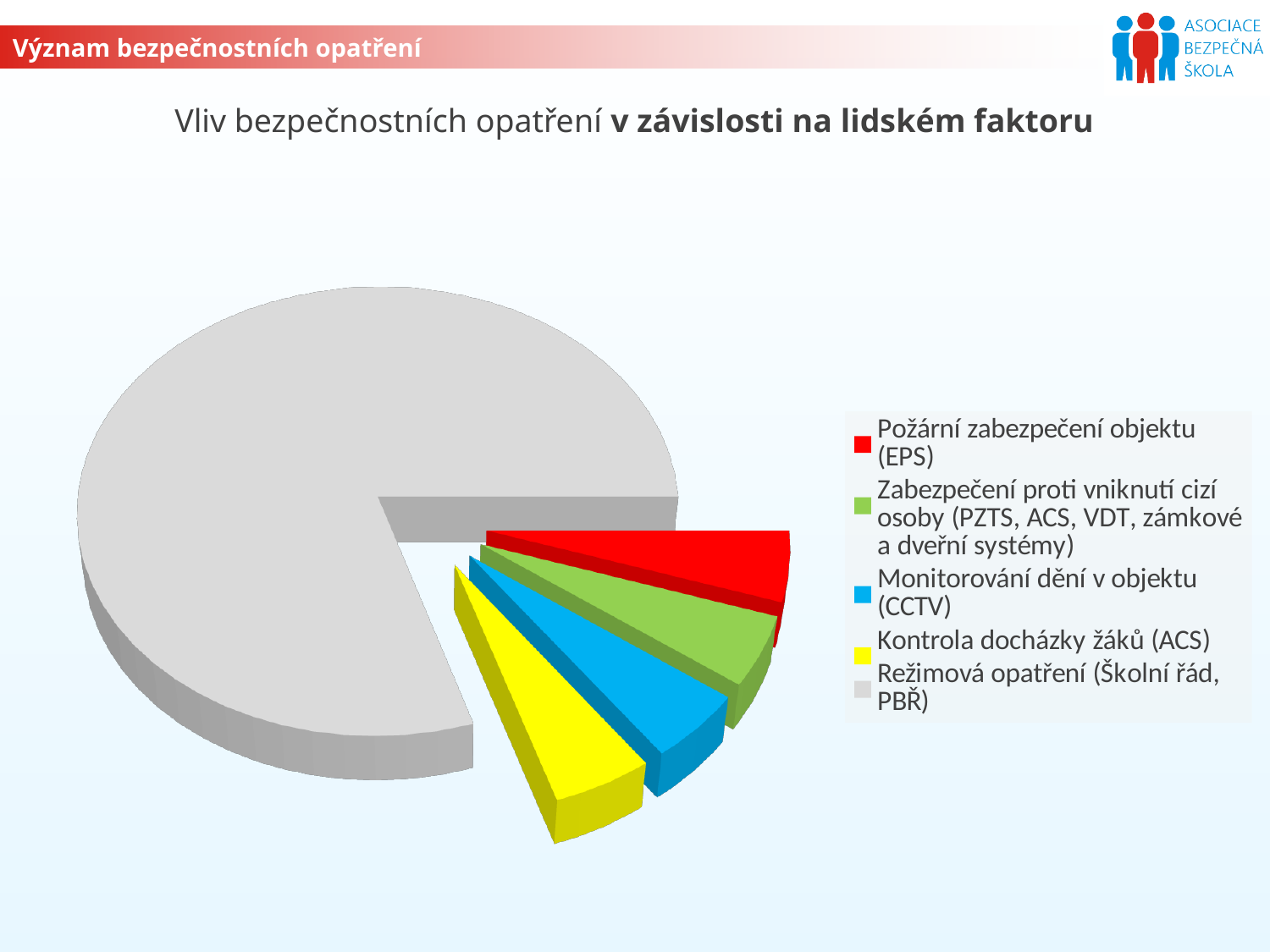
What kind of chart is shown on the slide? pie chart What is the title shown above the pie chart? Vliv bezpečnostních opatření v závislosti na lidském faktoru Which category is shown in yellow in the pie chart? Kontrola docházky žáků (ACS) Which slice is larger: Režimová opatření (Školní řád, PBŘ) or Monitorování dění v objektu (CCTV)? Režimová opatření (Školní řád, PBŘ) Which category has the largest slice in the pie chart? Režimová opatření (Školní řád, PBŘ) Is the Režimová opatření (Školní řád, PBŘ) slice larger than all the other slices combined? yes How many entries does the legend of the pie chart list? 5 How many slices does the pie chart have? 5 Which slice is larger: Režimová opatření (Školní řád, PBŘ) or Požární zabezpečení objektu (EPS)? Režimová opatření (Školní řád, PBŘ)